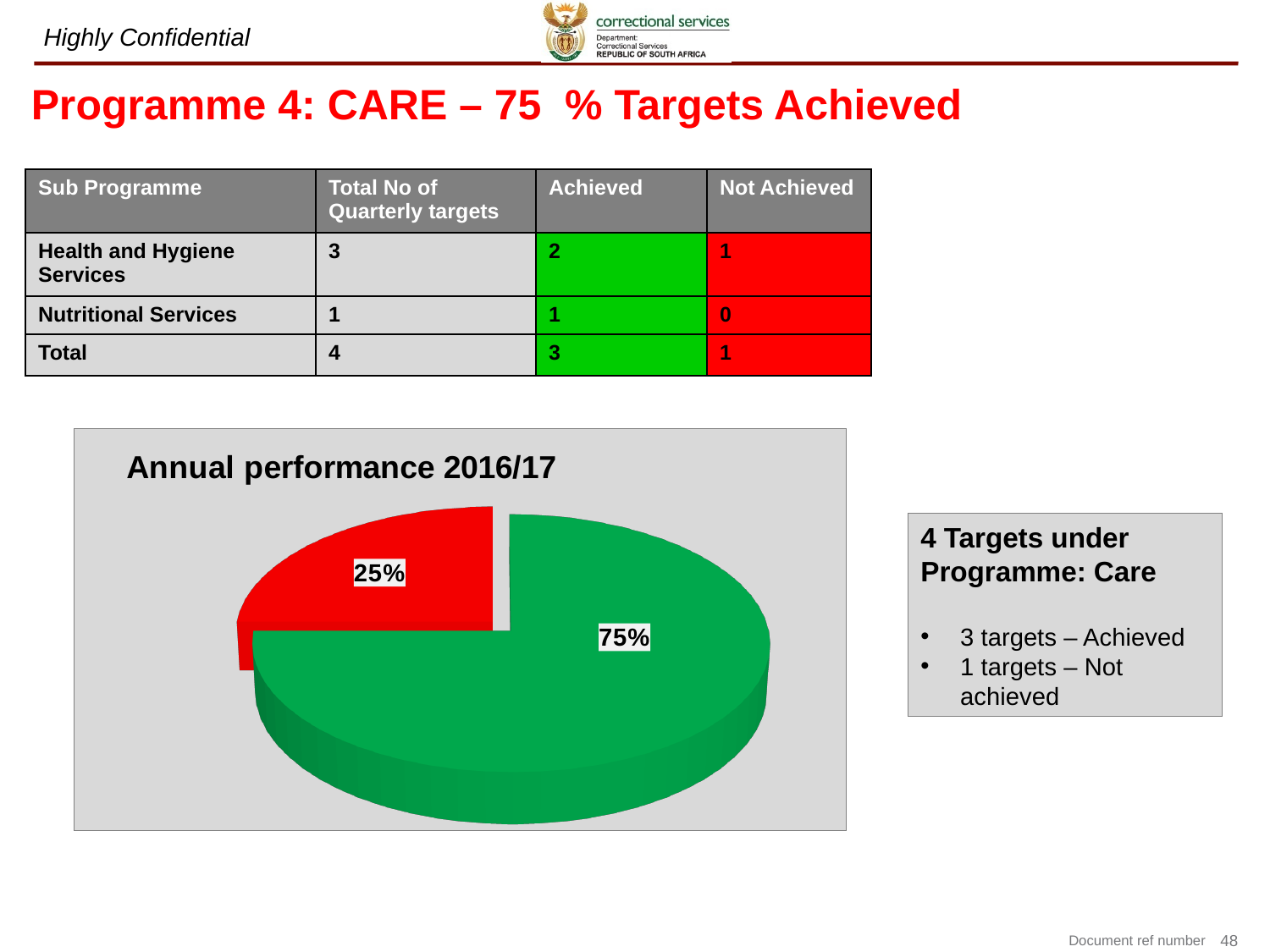
What kind of chart is shown under the title "Annual performance 2016/17"? pie chart What share of the pie chart does the red slice represent? 25% What percentage is shown on the green slice of the pie chart? 75% Is the green slice of the pie chart larger or smaller than the red slice? larger What colour is the slice labelled 75% in the pie chart? green What percentage is shown on the red slice of the pie chart? 25% How many slices does the pie chart have? 2 Which slice of the pie chart is the smallest, the green one or the red one? red Do the two slices of the pie chart add up to 100%? yes What is the title of the chart on the slide? Annual performance 2016/17 Which slice of the pie chart is the largest, the green one or the red one? green What is the difference in percentage points between the green slice and the red slice of the pie chart? 50